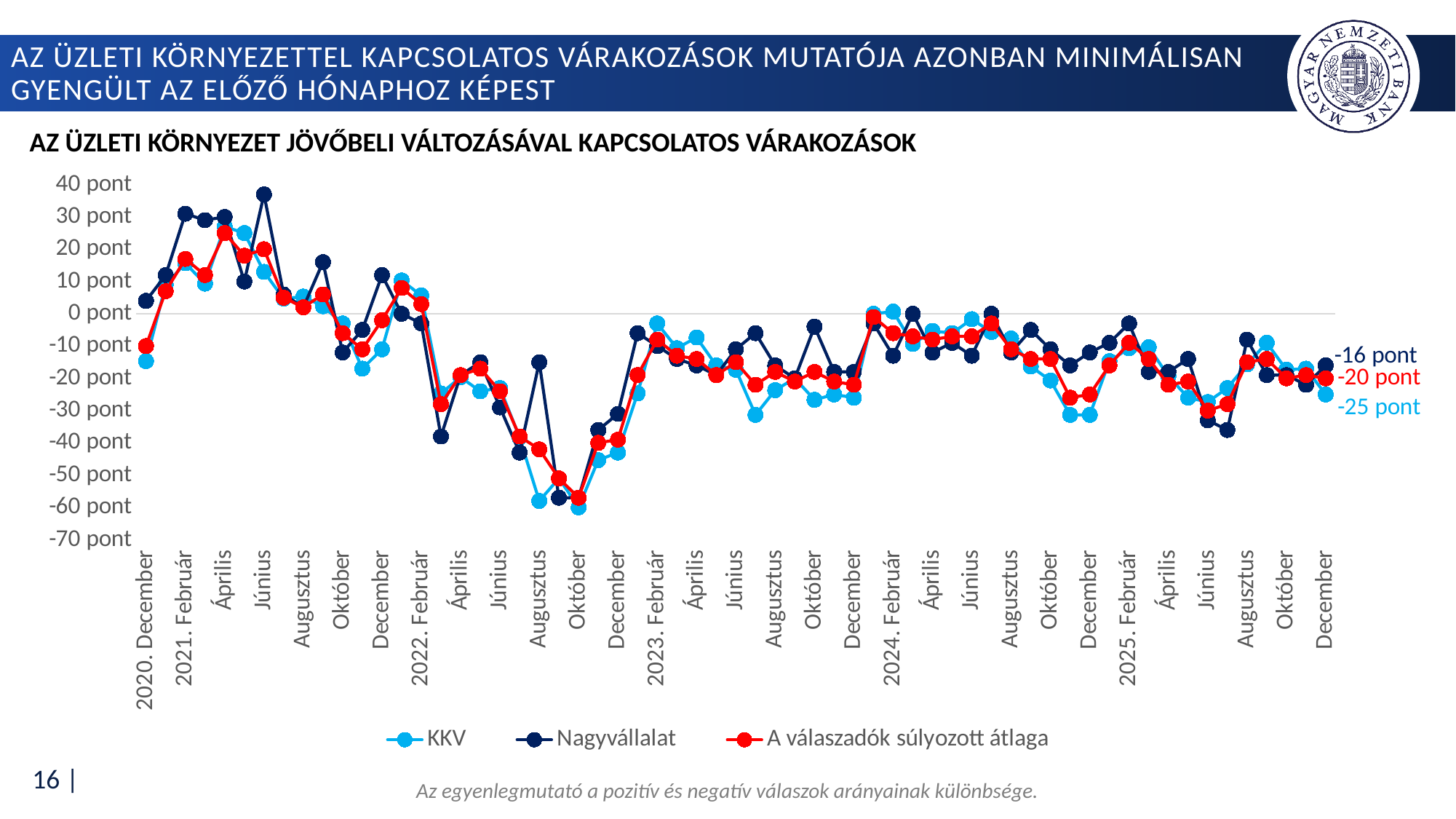
Is the value for Nagyvállalat in 2021 June greater or less than 30 pont? greater What kind of chart is shown on the slide? line chart Which series has the lowest value at the last point of the chart (2025 December)? KKV Do the values generally rise or fall between 2021 June and 2022 October? fall Is the value for KKV in 2022 October greater or less than -50 pont? less How many series does the legend list? 3 What is the value of the KKV series at the last point (2025 December)? -25 pont At the last point (2025 December), is the value for Nagyvállalat or for KKV larger? Nagyvállalat Which series has the highest value at the last point of the chart (2025 December)? Nagyvállalat What is the value of 'A válaszadók súlyozott átlaga' at the last point (2025 December)? -20 pont What is the value of the Nagyvállalat series at the last point (2025 December)? -16 pont What is the difference between the Nagyvállalat and KKV values at the last point (2025 December)? 9 pont